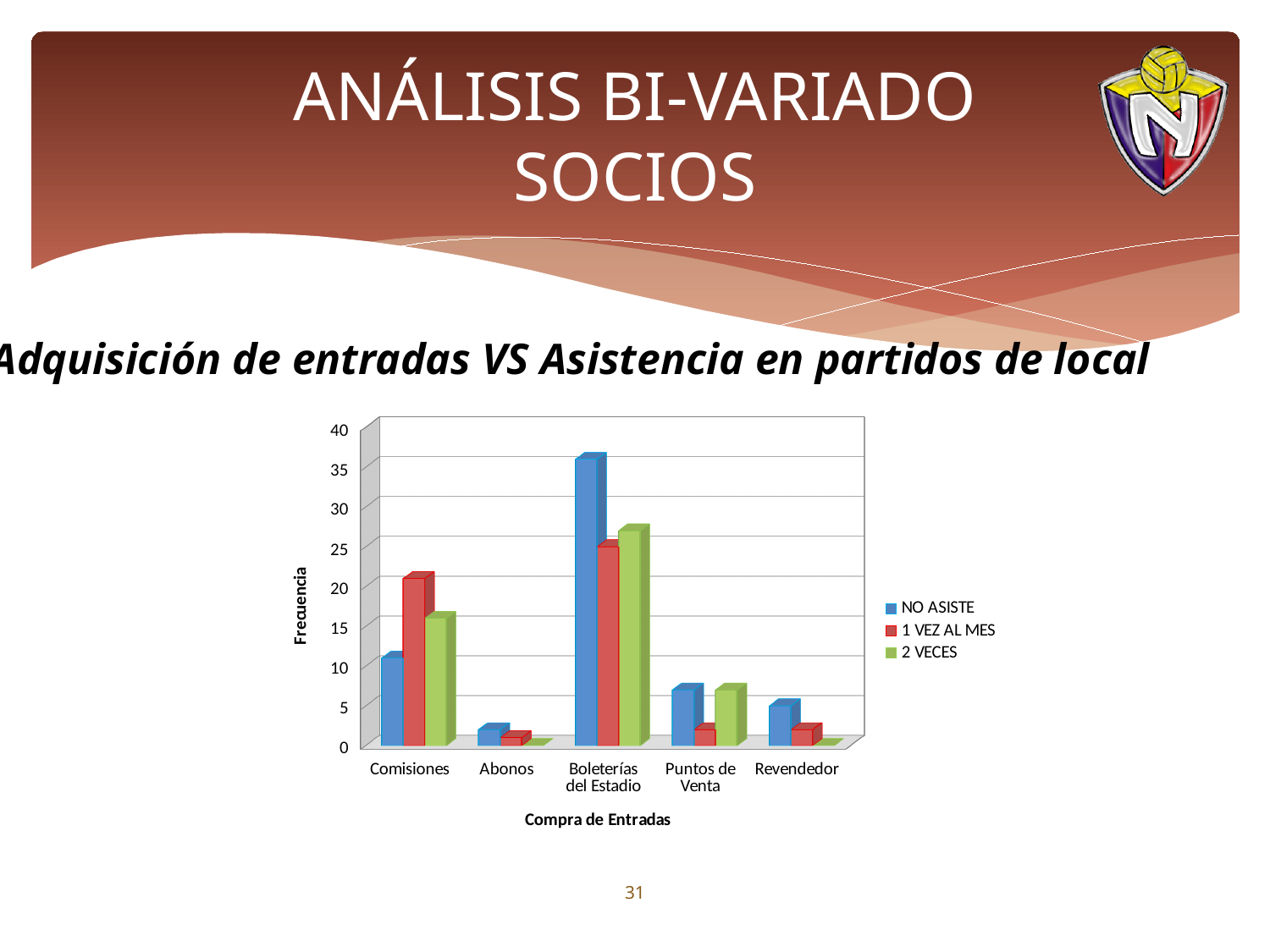
How many series does the legend list? 3 Which category has the highest NO ASISTE bar? Boleterías del Estadio How many categories are shown on the x axis? 5 For Boleterías del Estadio, which is larger: the NO ASISTE bar or the 2 VECES bar? NO ASISTE For Comisiones, which is larger: the NO ASISTE bar or the 1 VEZ AL MES bar? 1 VEZ AL MES What kind of chart is shown on the slide? Bar chart Is the NO ASISTE value for Revendedor greater or less than 10? less What is the title of the vertical axis? Frecuencia Is the 2 VECES value for Boleterías del Estadio greater or less than 20? greater Is the 1 VEZ AL MES value for Comisiones greater or less than 15? greater Which category has the lowest NO ASISTE bar? Abonos